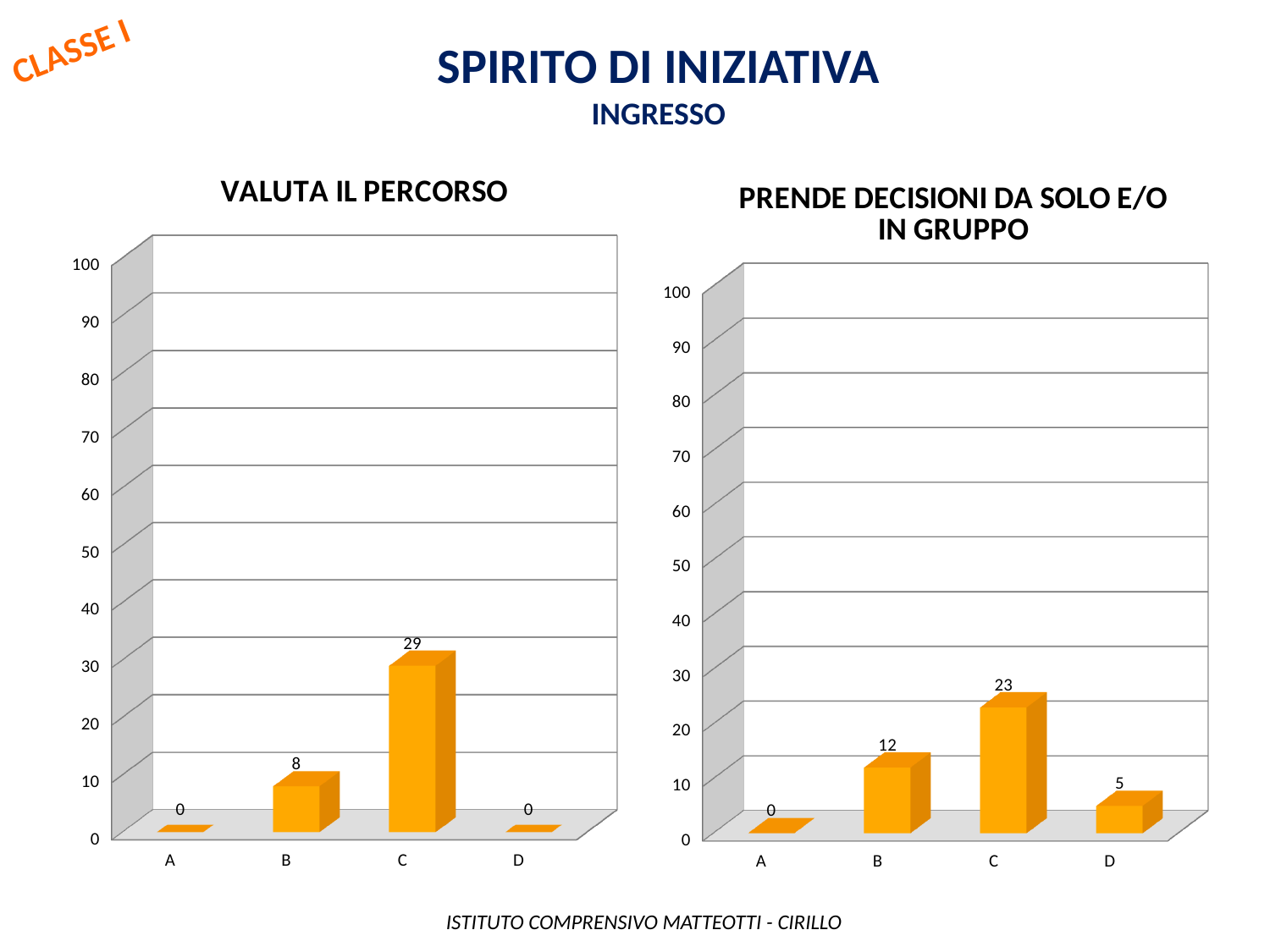
In the 'PRENDE DECISIONI DA SOLO E/O IN GRUPPO' chart, which category has the highest value? C In the 'VALUTA IL PERCORSO' chart, which category has the highest value? C How many categories are shown on the x axis of the 'VALUTA IL PERCORSO' chart? 4 In the 'PRENDE DECISIONI DA SOLO E/O IN GRUPPO' chart, which category has the lowest value? A In the 'PRENDE DECISIONI DA SOLO E/O IN GRUPPO' chart, what is the value for category D? 5 In the 'PRENDE DECISIONI DA SOLO E/O IN GRUPPO' chart, what is the difference between the values for C and D? 18 In the 'VALUTA IL PERCORSO' chart, what is the value for category C? 29 Which is larger: the value for C in the 'VALUTA IL PERCORSO' chart or the value for C in the 'PRENDE DECISIONI DA SOLO E/O IN GRUPPO' chart? VALUTA IL PERCORSO What kind of chart is the 'PRENDE DECISIONI DA SOLO E/O IN GRUPPO' chart? Bar chart In the 'VALUTA IL PERCORSO' chart, what is the difference between the values for C and B? 21 In the 'PRENDE DECISIONI DA SOLO E/O IN GRUPPO' chart, what is the value for category B? 12 In the 'VALUTA IL PERCORSO' chart, what is the value for category B? 8